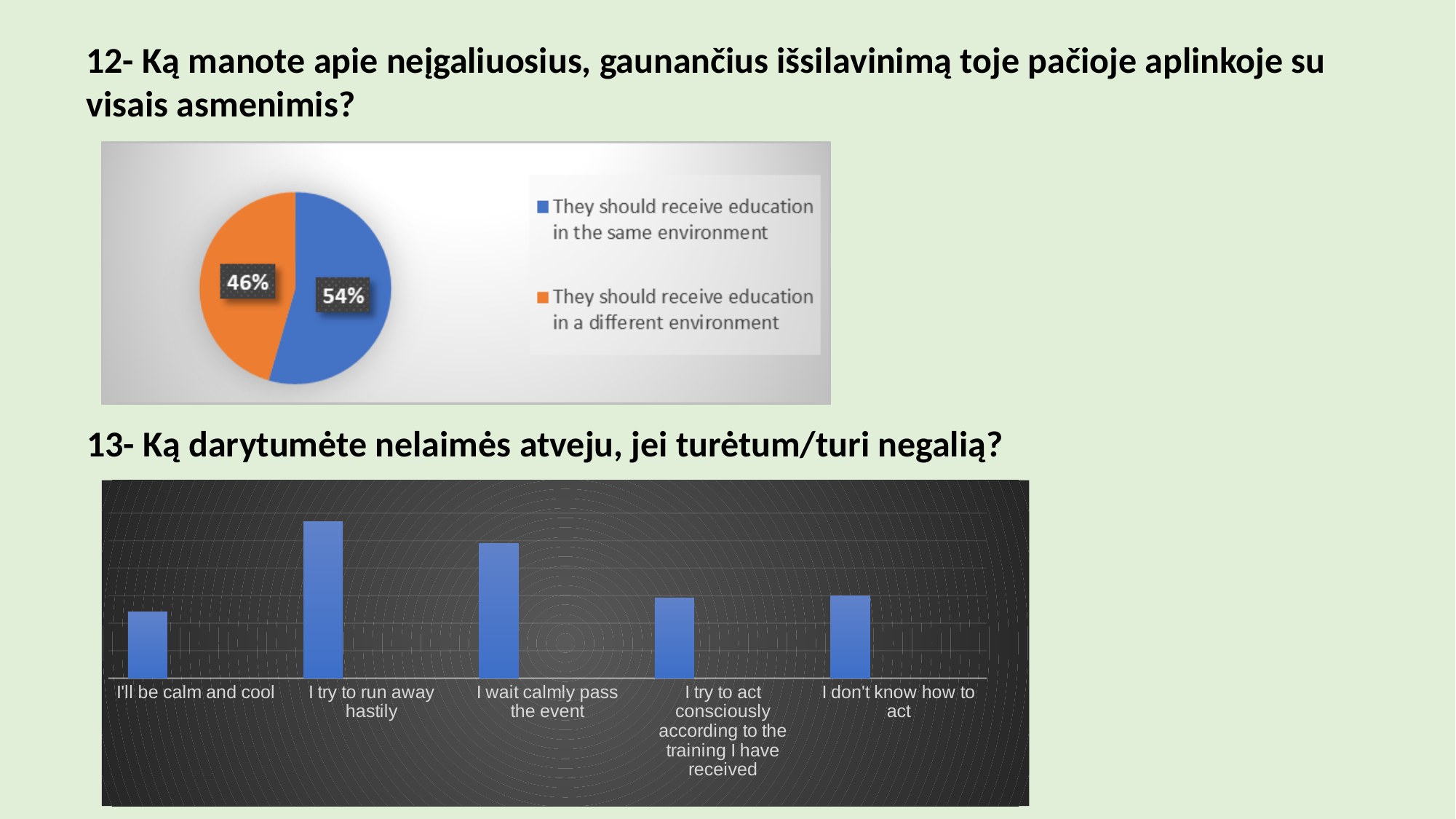
What kind of chart is shown for question 13? Bar chart In the pie chart for question 12, what share of respondents said they should receive education in a different environment? 46% In the bar chart for question 13, which category has the highest bar? I try to run away hastily In the pie chart for question 12, which option has the larger share? They should receive education in the same environment In the pie chart for question 12, what colour is the slice for 'They should receive education in a different environment'? Orange In the bar chart for question 13, which is larger: 'I'll be calm and cool' or 'I don't know how to act'? I don't know how to act In the bar chart for question 13, which is larger: 'I try to run away hastily' or 'I wait calmly pass the event'? I try to run away hastily In the bar chart for question 13, how many categories are shown? 5 In the pie chart for question 12, what share of respondents said they should receive education in the same environment? 54% In the pie chart for question 12, how many entries does the legend list? 2 In the bar chart for question 13, which category has the lowest bar? I'll be calm and cool In the pie chart for question 12, what is the difference in percentage points between the two slices? 8